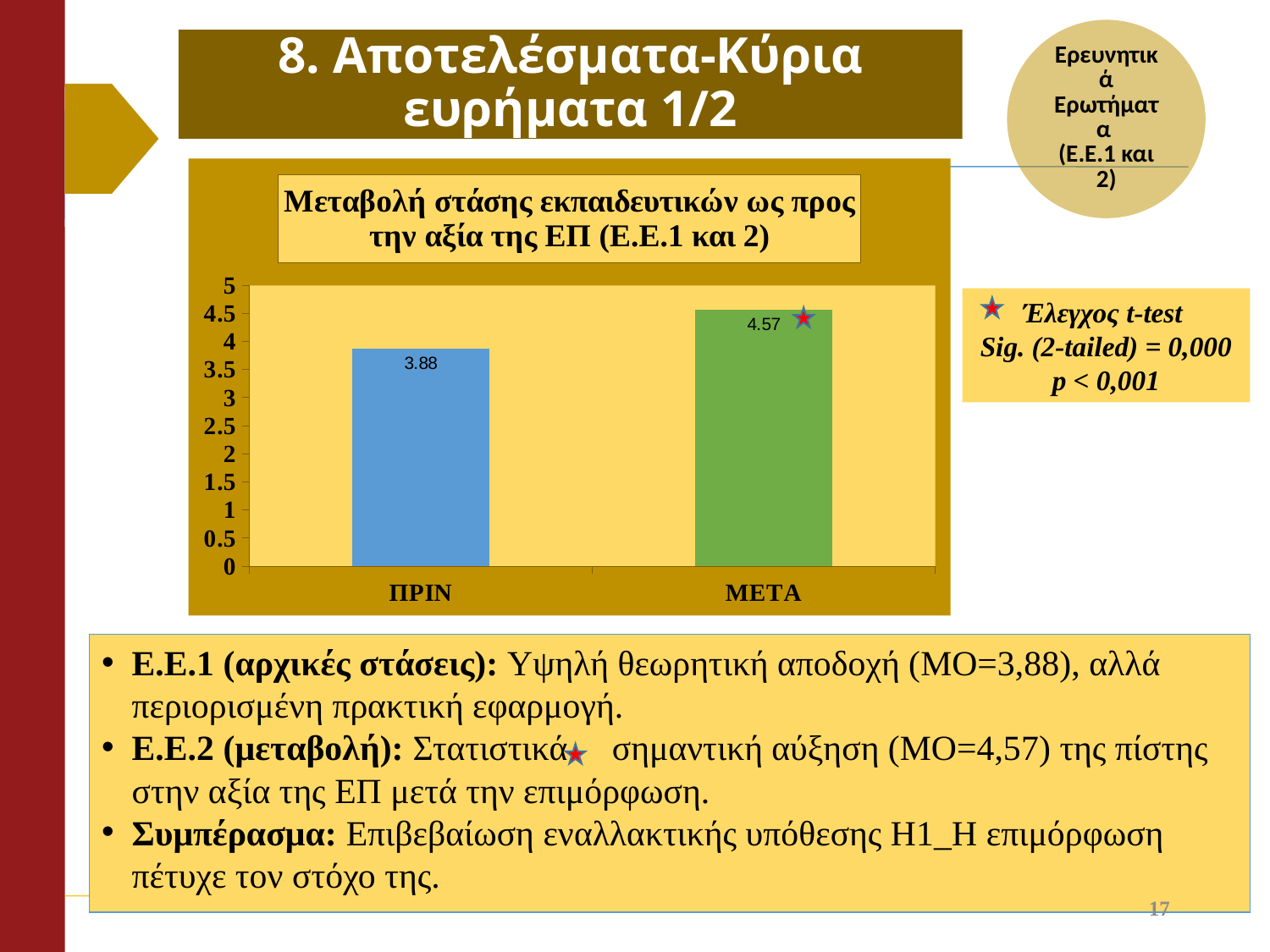
Is the value for ΜΕΤΑ greater or less than 4.5? greater What is the title of the chart? Μεταβολή στάσης εκπαιδευτικών ως προς την αξία της ΕΠ (Ε.Ε.1 και 2) What is the difference between the values for ΜΕΤΑ and ΠΡΙΝ? 0.69 Which is larger, the value for ΠΡΙΝ or the value for ΜΕΤΑ? ΜΕΤΑ What kind of chart is shown on the slide? bar chart What is the value for ΜΕΤΑ? 4.57 Is the value for ΠΡΙΝ greater or less than 4? less Which category has the lowest value? ΠΡΙΝ What is the value for ΠΡΙΝ? 3.88 How many categories are shown on the x axis? 2 Do the values rise or fall from ΠΡΙΝ to ΜΕΤΑ? rise Which category has the highest value? ΜΕΤΑ